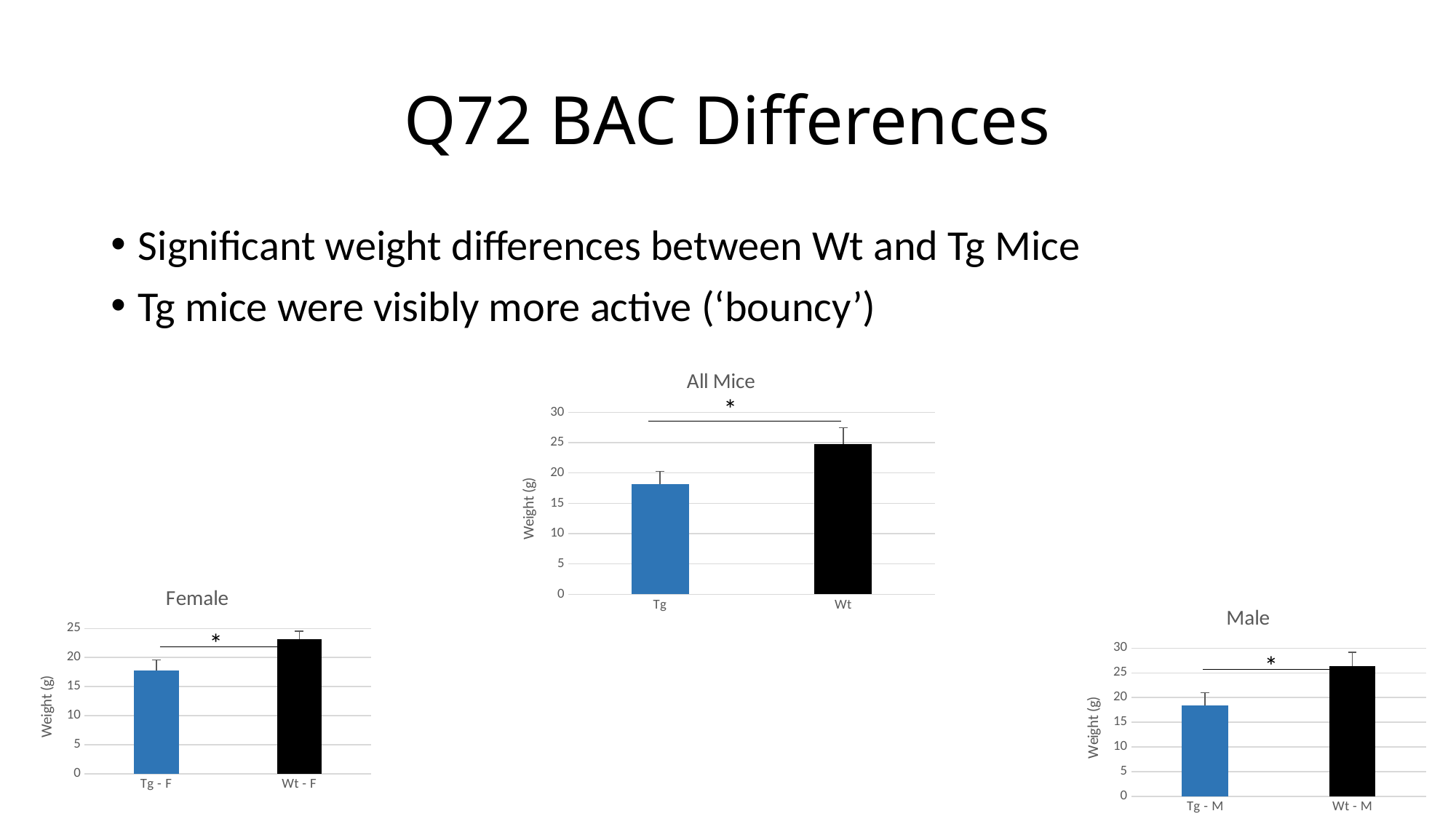
In the All Mice chart, which category has the higher weight, Tg or Wt? Wt What is the y-axis title of the Female chart? Weight (g) In the Male chart, which category has the highest weight? Wt - M In the Female chart, is the value for Wt - F greater or less than 20? greater What kind of chart is the All Mice chart? bar chart In the Female chart, which category has the lowest weight? Tg - F In the All Mice chart, is the value for Tg greater or less than 20? less In the Female chart, is the value for Tg - F greater or less than 15? greater How many categories are shown in the Male chart? 2